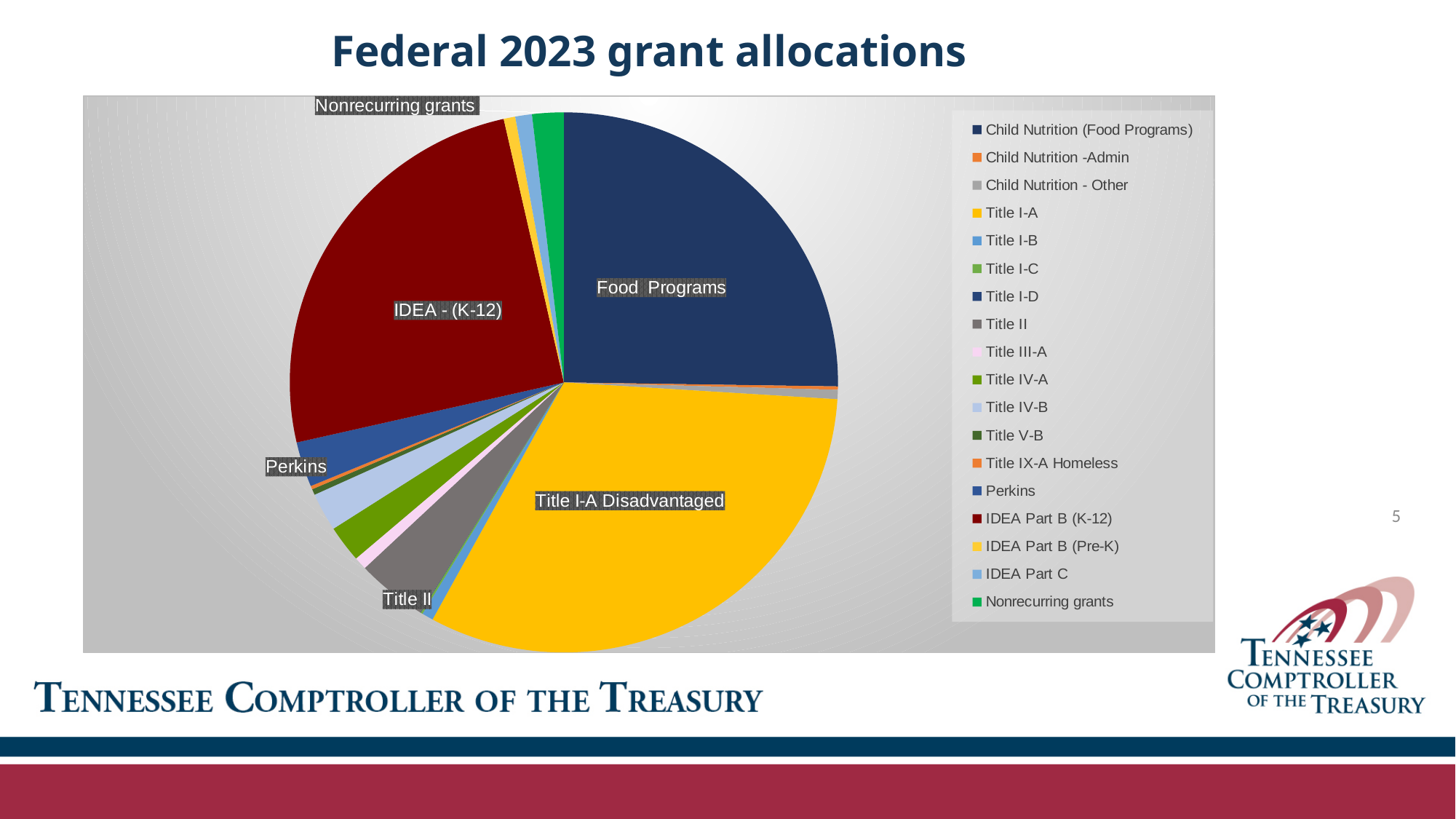
What kind of chart is shown on the slide? Pie chart What colour is the Nonrecurring grants slice in the pie chart? Green Which slice is larger, Title I-A Disadvantaged or Food Programs? Title I-A Disadvantaged Which slice is larger, IDEA - (K-12) or Title II? IDEA - (K-12) What is the title of the chart on the slide? Federal 2023 grant allocations Which slice is larger, Food Programs or Perkins? Food Programs Which category has the largest slice of the pie? Title I-A Disadvantaged How many categories does the legend of the pie chart list? 18